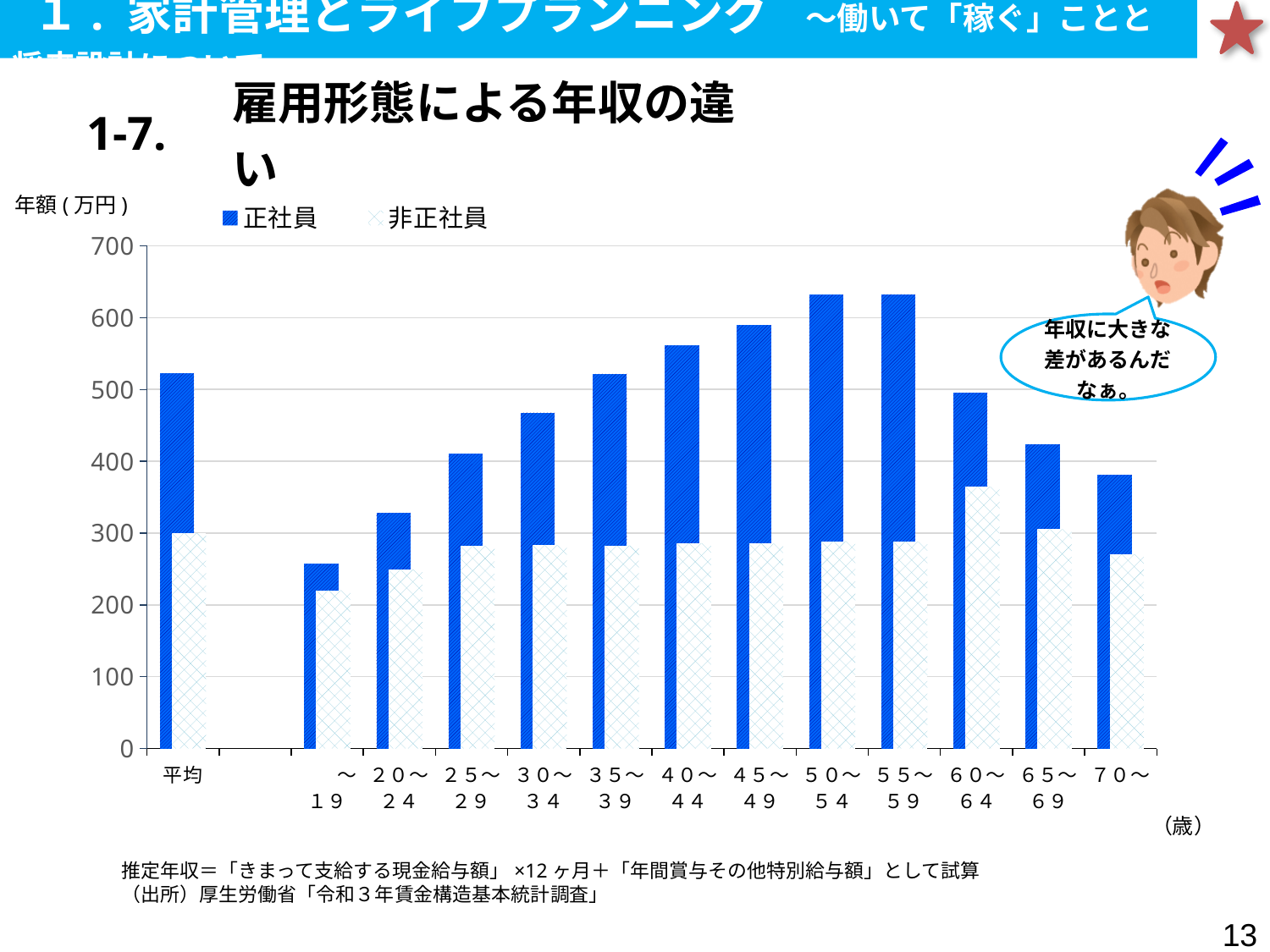
What are the two series named in the legend? 正社員 and 非正社員 What kind of chart is shown on the slide? bar chart How many series does the legend list? 2 For the 平均 category, which series has the larger value, 正社員 or 非正社員? 正社員 Which age category has the lowest value for 非正社員? ～19 Do the 正社員 values rise or fall from ～19 to 50～54? rise Is the 正社員 value for 平均 greater or less than 500? greater Which age category has the highest value for 非正社員? 60～64 Which age category has the lowest value for 正社員? ～19 Is the 正社員 value for 70～ greater or less than 400? less Is the 非正社員 value for 60～64 greater or less than 300? greater How many categories are labelled on the x axis? 13